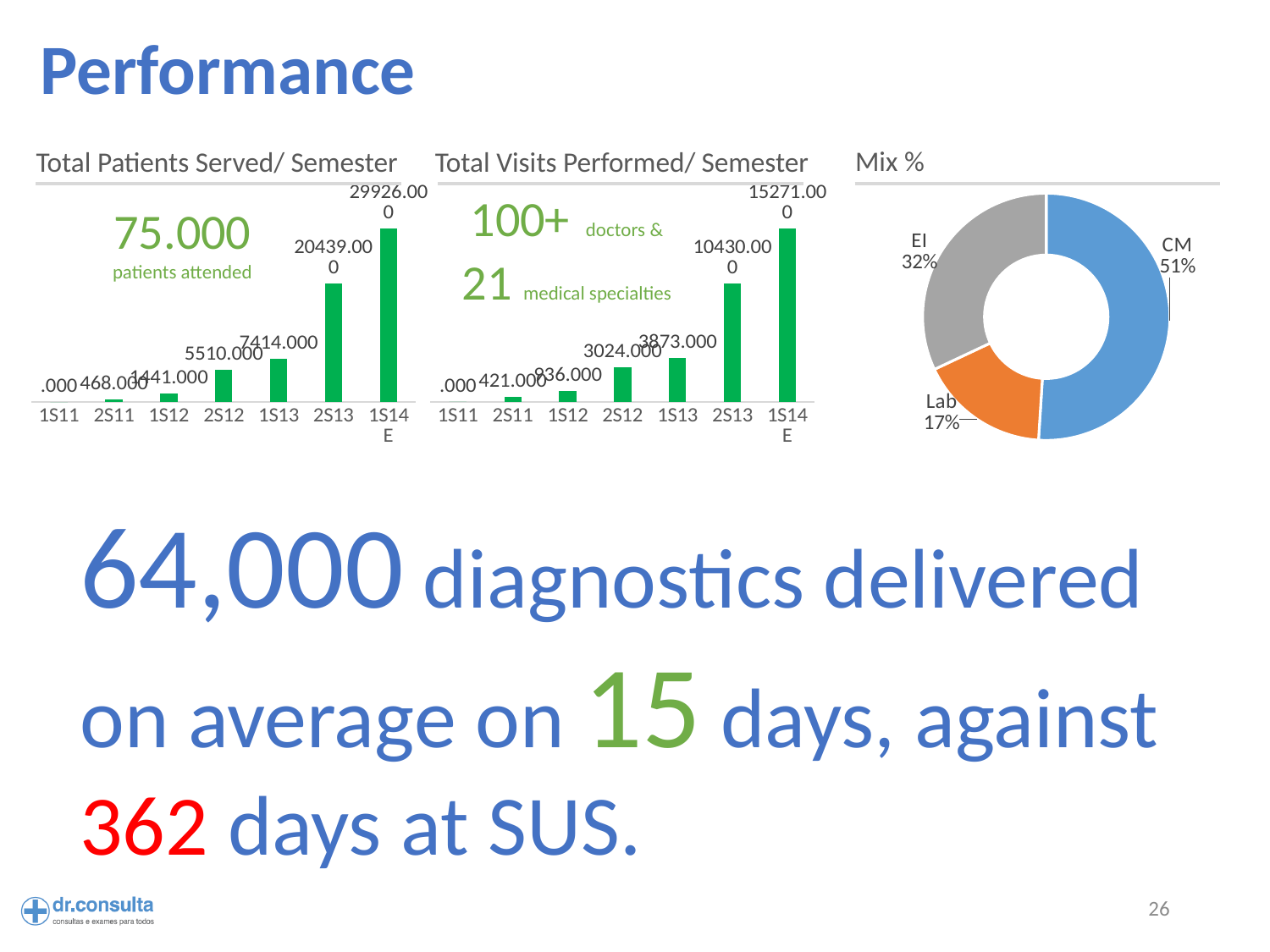
In the 'Total Patients Served/ Semester' chart, do the values rise or fall from 1S11 to 1S14 E? rise In the 'Total Patients Served/ Semester' chart, how many semesters are shown on the x axis? 7 In the 'Total Visits Performed/ Semester' chart, what is the value for 2S13? 10430.000 In the 'Total Visits Performed/ Semester' chart, which is larger, the value for 2S12 or the value for 1S13? 1S13 In the 'Total Visits Performed/ Semester' chart, what is the difference between the values for 1S14 E and 2S13? 4841.000 In the 'Total Patients Served/ Semester' chart, what is the value for 2S13? 20439.000 What kind of chart is the 'Mix %' chart? Donut chart In the 'Total Patients Served/ Semester' chart, which semester has the highest value? 1S14 E In the 'Mix %' chart, what share does CM have? 51% In the 'Total Patients Served/ Semester' chart, what is the value for 1S14 E? 29926.000 In the 'Mix %' chart, which category has the smallest share? Lab In the 'Total Visits Performed/ Semester' chart, what is the value for 1S14 E? 15271.000